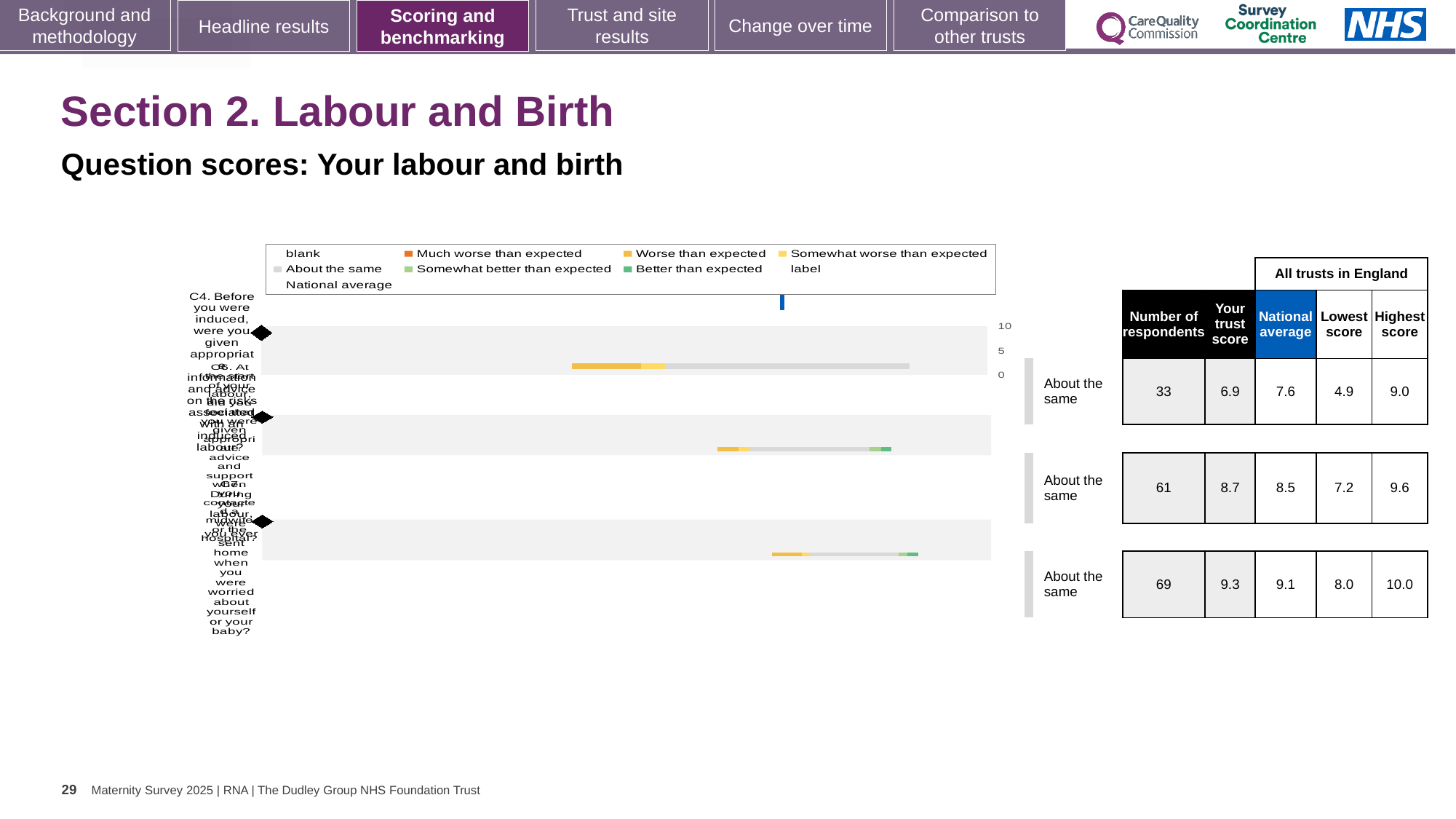
Which row of the table has the highest "Your trust score"? The third row (9.3) In the first row of the table, is "Your trust score" higher or lower than the national average? Lower How many question rows are shown in the chart and table? 3 In the chart legend, what colour represents "Better than expected"? Green In the table beside the chart, what is the highest score in the third row? 10.0 In the table beside the chart, what is the number of respondents in the first row? 33 What benchmark category is shown next to each of the three questions? About the same In the table beside the chart, what is the national average in the third row? 9.1 What kind of chart is shown on the slide? Bar chart In the chart legend, what colour represents "Much worse than expected"? Orange In the table beside the chart, what is "Your trust score" in the second row? 8.7 In the first row of the table, what is the difference between the highest score and the lowest score? 4.1